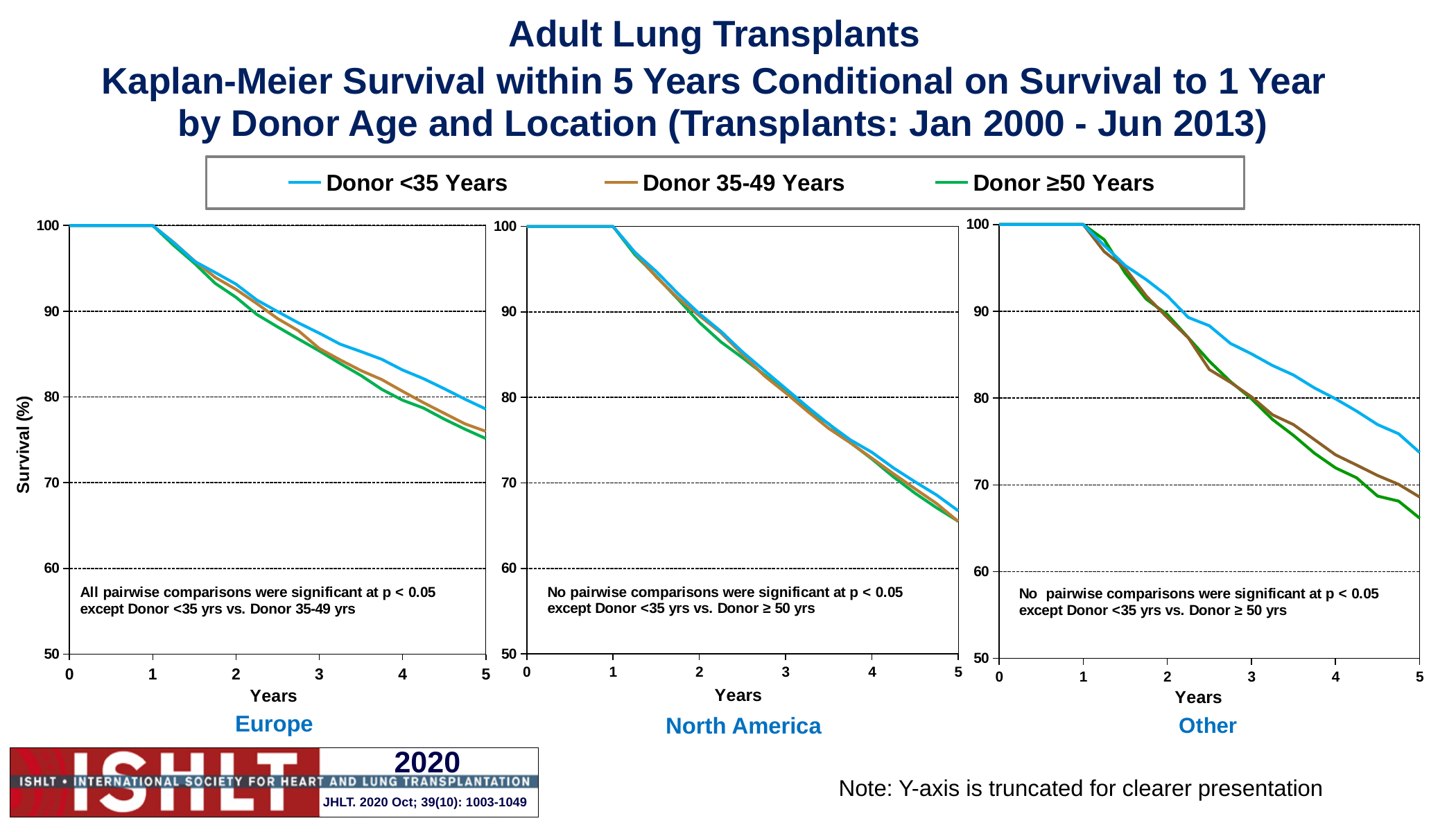
What type of chart is used for the Europe panel? line chart How many series does the legend list? 3 In the Other chart, do the survival curves rise or fall as years increase from 1 to 5? fall In the Europe chart, at year 5, which is larger: Donor <35 Years or Donor ≥50 Years? Donor <35 Years In the Europe chart, what is the survival value for Donor <35 Years at year 1? 100 In the Other chart, which series has the lowest survival at year 5? Donor ≥50 Years In the Other chart, which series has the highest survival at year 5? Donor <35 Years In the North America chart, is the value for Donor <35 Years at year 5 greater or less than 70? less In the Europe chart, is the value for Donor <35 Years at year 5 greater or less than 70? greater In the Other chart, is the value for Donor ≥50 Years at year 5 greater or less than 70? less What colour is the line for Donor <35 Years in the legend? blue In the North America chart, what is the survival value for Donor 35-49 Years at year 1? 100